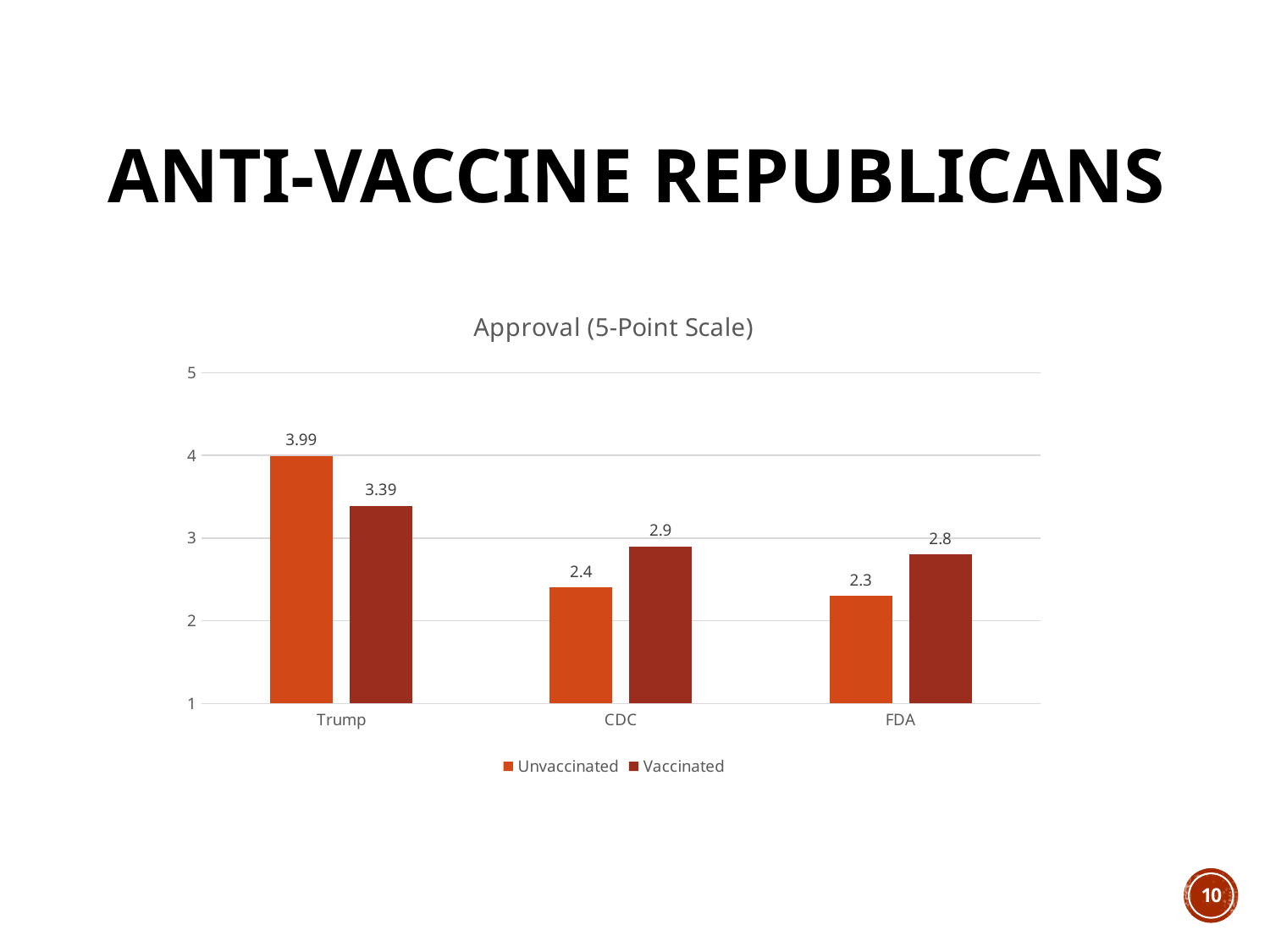
What is the title of the chart? Approval (5-Point Scale) What kind of chart is shown on the slide? bar chart Is the Vaccinated value for FDA greater or less than 3? less How many series does the legend list? 2 How many categories are shown on the x axis? 3 What is the difference between the Unvaccinated and Vaccinated values for Trump? 0.6 What is the Unvaccinated approval value for Trump? 3.99 Which category has the lowest Unvaccinated approval value? FDA Which category has the highest Vaccinated approval value? Trump What is the Vaccinated approval value for CDC? 2.9 Which is larger for CDC, the Unvaccinated value or the Vaccinated value? Vaccinated What is the Unvaccinated approval value for FDA? 2.3